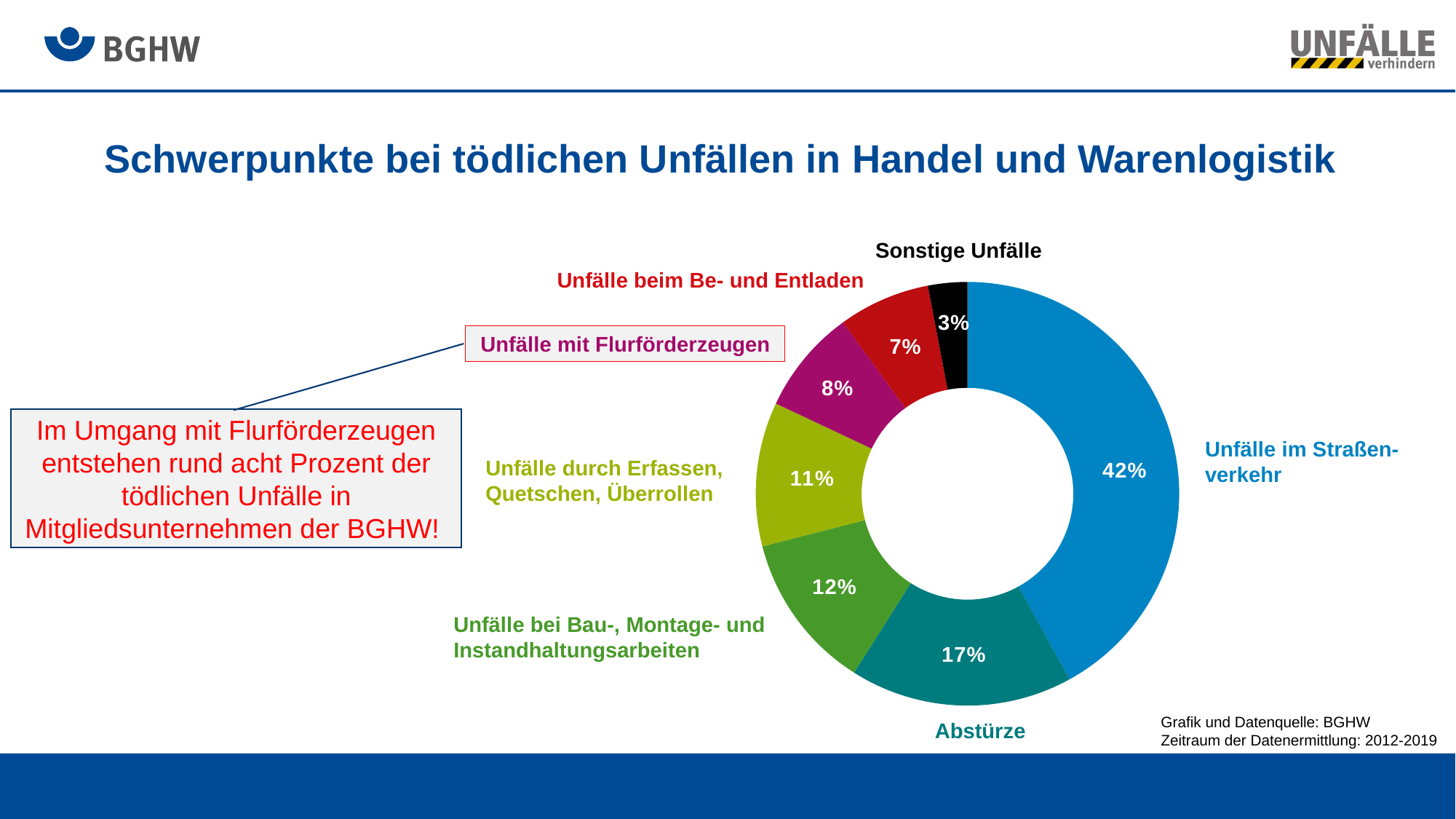
What is the difference in percentage points between Abstürze and Unfälle durch Erfassen, Quetschen, Überrollen? 6 What share of fatal accidents is attributed to Unfälle im Straßenverkehr? 42% What percentage is shown for Abstürze? 17% What is the value for Unfälle bei Bau-, Montage- und Instandhaltungsarbeiten? 12% Which category has the largest share of the chart? Unfälle im Straßenverkehr Which is larger: Unfälle bei Bau-, Montage- und Instandhaltungsarbeiten or Unfälle mit Flurförderzeugen? Unfälle bei Bau-, Montage- und Instandhaltungsarbeiten What percentage is shown for Unfälle beim Be- und Entladen? 7% Which category has the smallest share of the chart? Sonstige Unfälle What kind of chart is shown on the slide? Pie chart (donut) How many categories are shown in the chart? 7 What is the value for Unfälle mit Flurförderzeugen? 8% What is the title of the slide containing the chart? Schwerpunkte bei tödlichen Unfällen in Handel und Warenlogistik